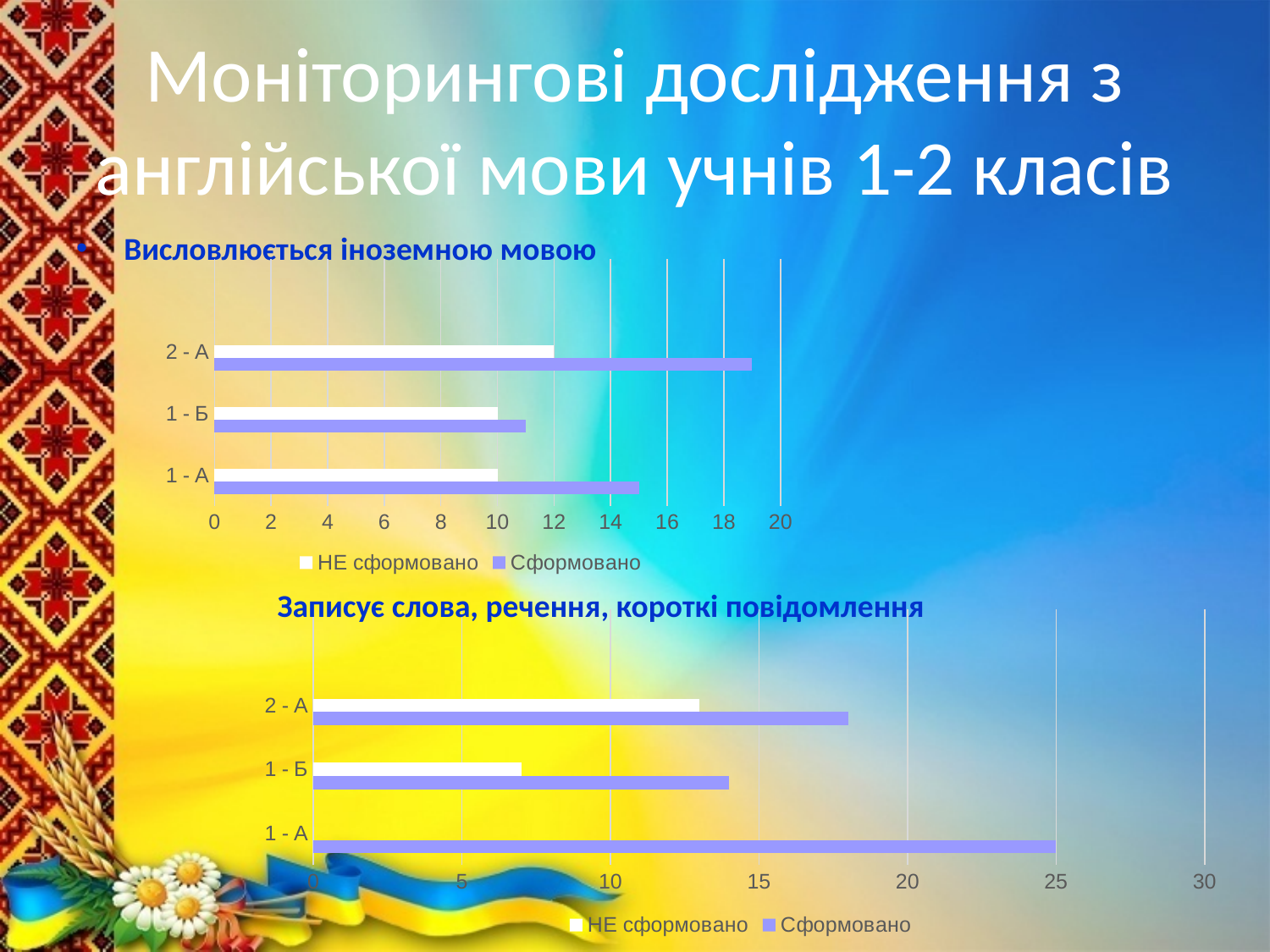
What kind of chart is the top chart titled "Висловлюється іноземною мовою"? bar chart In the top chart "Висловлюється іноземною мовою", which category has the highest value for Сформовано? 2 - А In the top chart "Висловлюється іноземною мовою", what is the НЕ сформовано value for 2 - А? 12 In the top chart "Висловлюється іноземною мовою", for 1 - А, which series has the larger value: Сформовано or НЕ сформовано? Сформовано In the top chart "Висловлюється іноземною мовою", is the Сформовано value for 2 - А greater or less than 18? greater In the bottom chart "Записує слова, речення, короткі повідомлення", is the НЕ сформовано value for 1 - Б greater or less than 10? less In the bottom chart "Записує слова, речення, короткі повідомлення", which category has the highest value for Сформовано? 1 - А What are the two legend entries of the top chart "Висловлюється іноземною мовою"? НЕ сформовано and Сформовано How many series does the legend of the bottom chart "Записує слова, речення, короткі повідомлення" list? 2 In the bottom chart "Записує слова, речення, короткі повідомлення", is the Сформовано value for 2 - А greater or less than 15? greater How many categories are shown on the top chart "Висловлюється іноземною мовою"? 3 In the bottom chart "Записує слова, речення, короткі повідомлення", what is the Сформовано value for 1 - А? 25